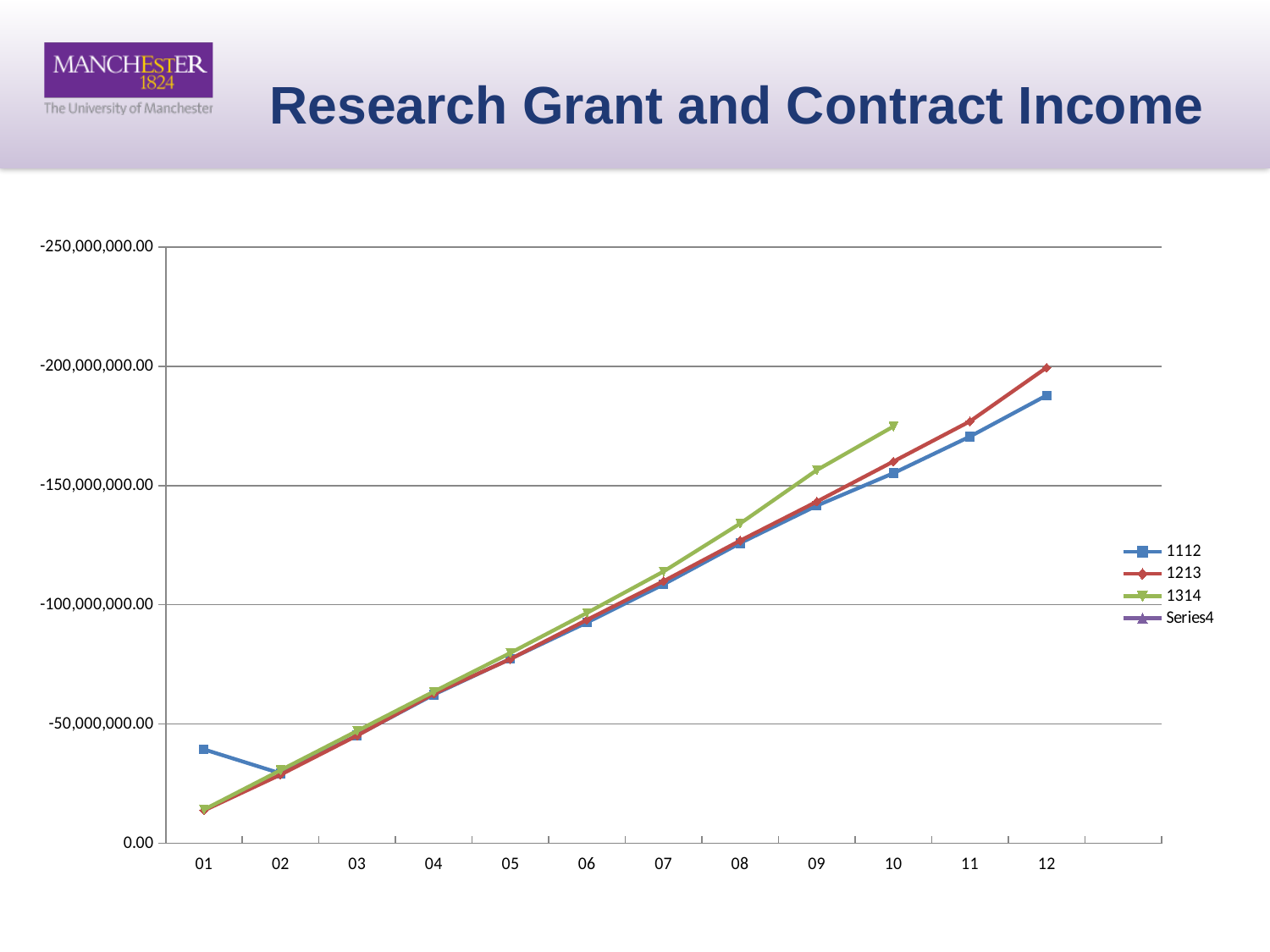
At 01, which series has the value furthest from 0.00? 1112 What kind of chart is shown on the slide? line chart At 10, which series has the value furthest from 0.00? 1314 At 09, which series is further from 0.00, 1314 or 1112? 1314 How many categories are labelled along the x axis? 12 What is the title of the slide's chart? Research Grant and Contract Income How many data points are plotted for the 1314 series? 10 How many series does the legend list? 4 From 01 to 12, do the plotted values become more negative or less negative? more negative Which series stops at 10 rather than continuing to 12? 1314 Which series is drawn in green? 1314